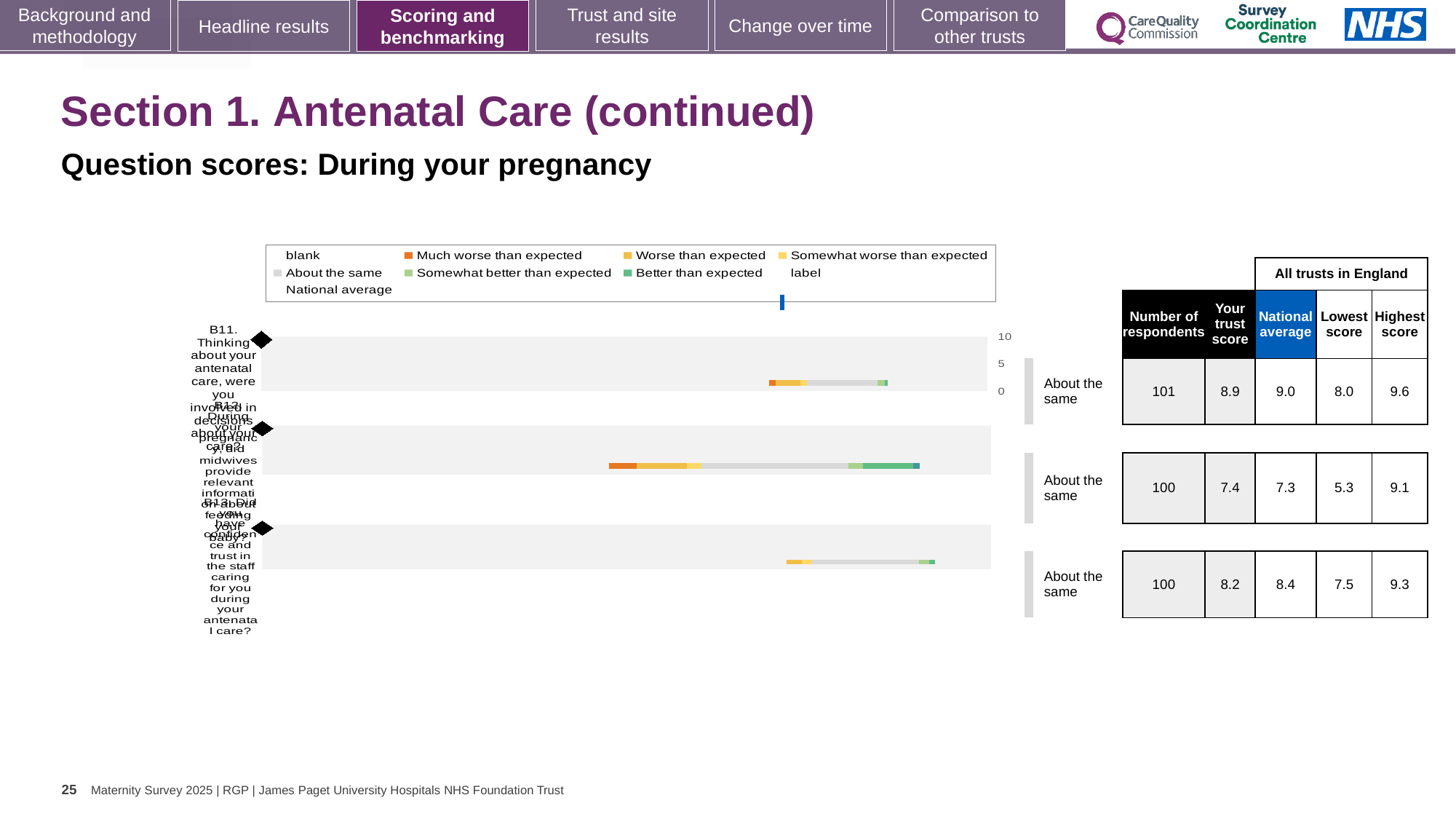
According to the table, what is the highest score among all trusts in England for question B13? 9.3 For question B12, what is the difference between the highest score and the lowest score among all trusts in England? 3.8 For question B13, is the trust score or the national average larger? National average According to the table, what is the national average for question B12? 7.3 According to the table, how many respondents answered question B11? 101 Which colour in the legend represents 'Much worse than expected'? orange How many questions (categories) are plotted in the chart? 3 Which question has the lowest trust score in the table? B12 According to the table, what is the trust score for question B11? 8.9 What kind of chart is shown on the slide? bar chart What is the maximum value shown on the chart's score axis? 10 Which question has the highest trust score in the table? B11